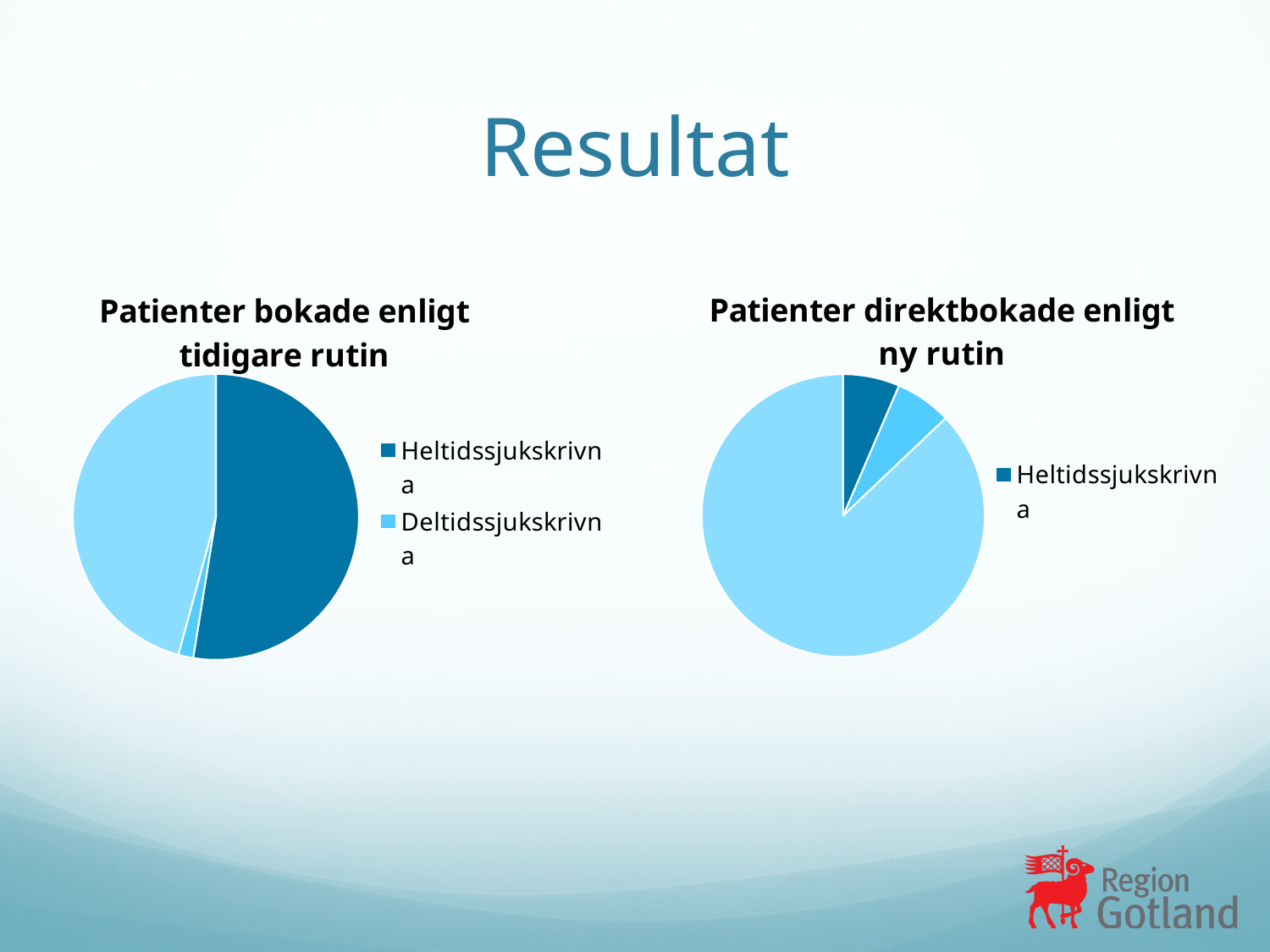
What kind of chart is "Patienter bokade enligt tidigare rutin"? pie chart How many entries does the legend of the right chart, "Patienter direktbokade enligt ny rutin", list? 1 What is the title of the left chart on the slide? Patienter bokade enligt tidigare rutin In the right chart, "Patienter direktbokade enligt ny rutin", is the light blue slice larger or smaller than the dark blue slice? larger In the left chart, "Patienter bokade enligt tidigare rutin", which legend entry is shown in dark blue? Heltidssjukskrivna How many slices does the pie in "Patienter bokade enligt tidigare rutin" have? 3 How many entries does the legend of the left chart, "Patienter bokade enligt tidigare rutin", list? 2 How many slices does the pie in "Patienter direktbokade enligt ny rutin" have? 3 What kind of chart is "Patienter direktbokade enligt ny rutin"? pie chart In the right chart, "Patienter direktbokade enligt ny rutin", which colour slice is the largest? light blue